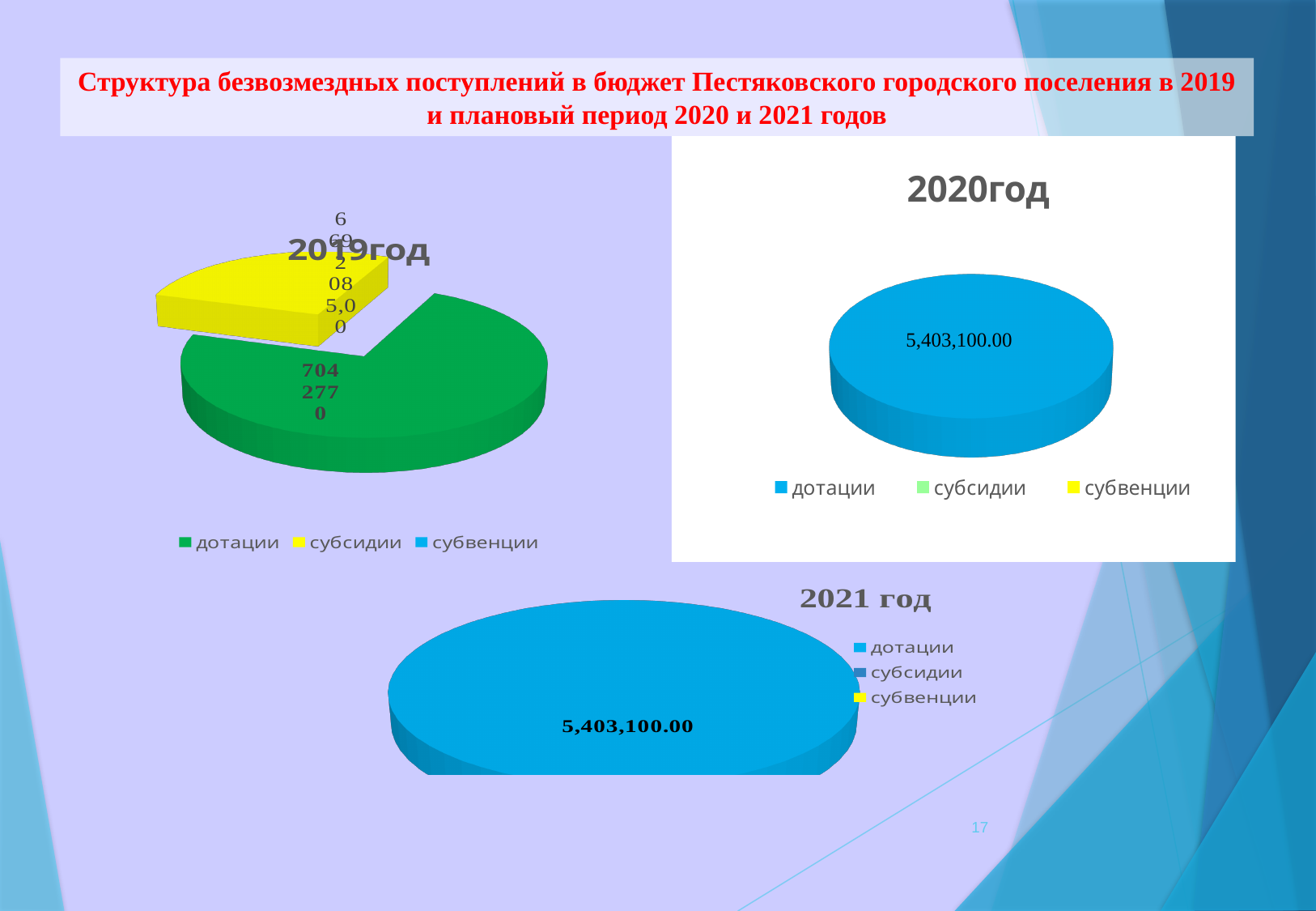
What kind of chart is the 2020год chart? pie chart In the 2019год chart, which is larger, дотации or субсидии? дотации In the 2020год chart, what share of the pie does дотации take? 100% In the 2019год chart, what colour is the дотации slice? green In the 2019год chart, which category has the largest slice? дотации How many slices are visible in the 2019год pie chart? 2 How many pie charts are shown on the slide? 3 What kind of chart is the 2019год chart? pie chart How many entries does the legend of the 2021 год chart list? 3 How many entries does the legend of the 2020год chart list? 3 In the 2020год chart, what value is printed on the дотации slice? 5,403,100.00 In the 2021 год chart, what value is printed on the дотации slice? 5,403,100.00